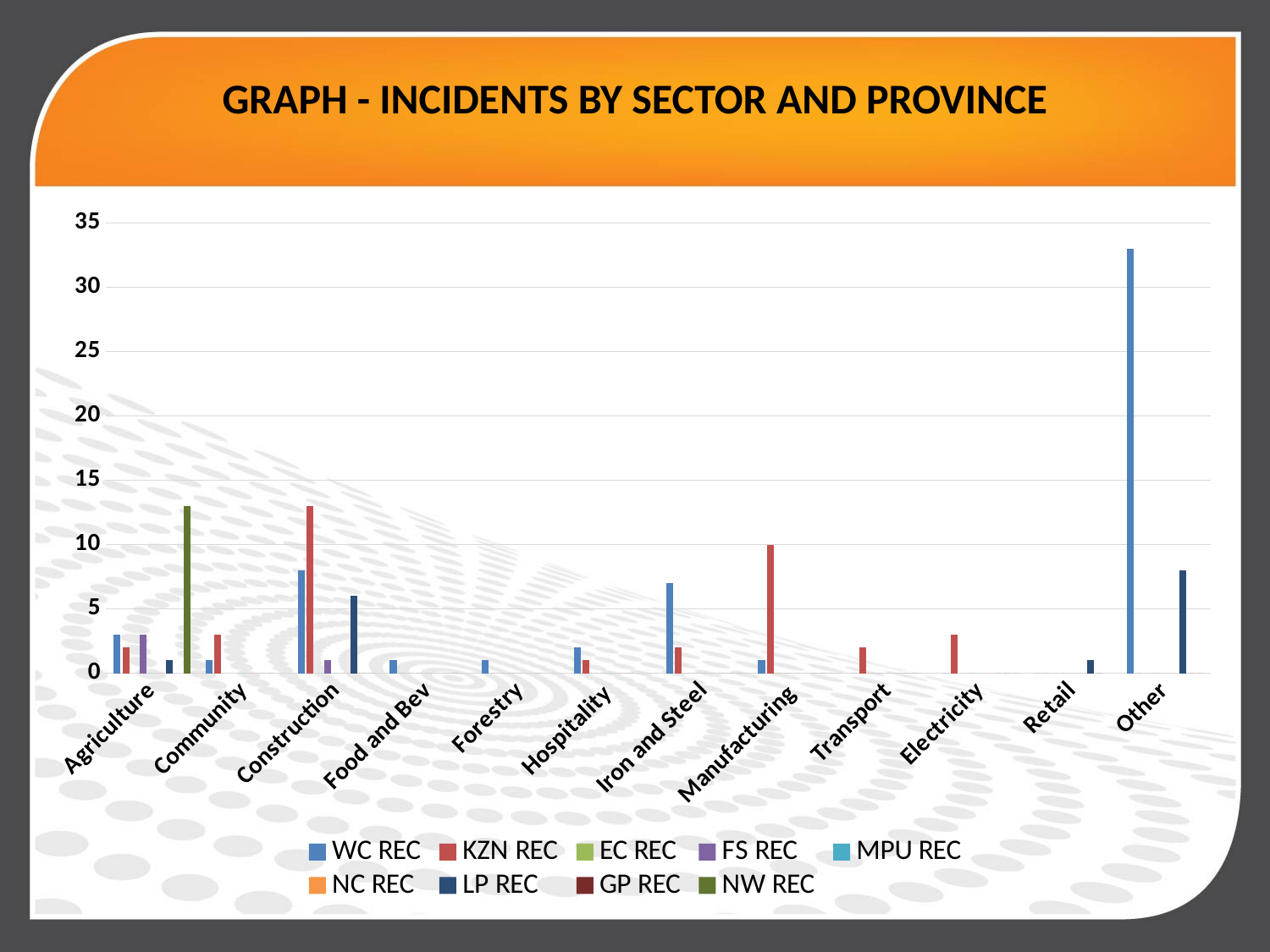
Which series is the only one with a bar for Retail? LP REC What kind of chart is shown on the slide? bar chart Which sector has the tallest bar in the chart? Other Is the KZN REC value for Construction greater or less than 10? greater For Construction, which is larger: the KZN REC bar or the WC REC bar? KZN REC Is the WC REC value for Other greater or less than 30? greater Is the NW REC value for Agriculture greater or less than 10? greater For Other, which is larger: the WC REC bar or the LP REC bar? WC REC How many sectors are shown along the x axis? 12 What is the title of the chart? GRAPH - INCIDENTS BY SECTOR AND PROVINCE How many series does the legend list? 9